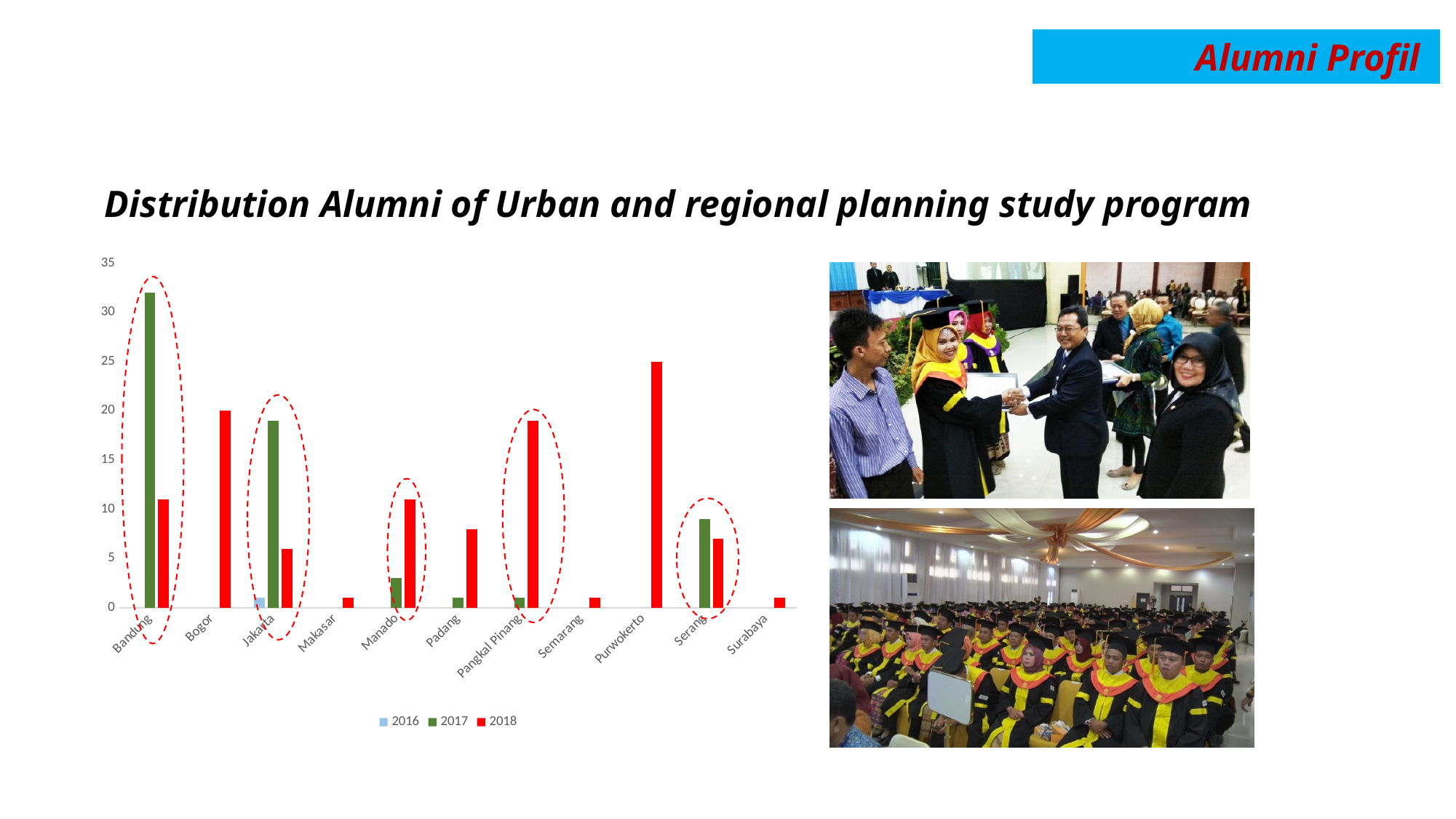
What kind of chart is shown on the slide? Bar chart How many cities are shown on the x axis of the chart? 11 Is the 2018 value for Jakarta greater or less than 10? less How many series does the chart legend list? 3 Which city has the highest value for the 2017 series? Bandung Which colour represents the 2018 series in the chart? Red Which is larger for Bandung, the 2017 value or the 2018 value? 2017 Is the 2017 value for Bandung greater or less than 30? greater What is the title of the chart? Distribution Alumni of Urban and regional planning study program Is the 2018 value for Purwokerto greater or less than 20? greater Which city has the highest value for the 2018 series? Purwokerto Which is larger for Manado, the 2017 value or the 2018 value? 2018